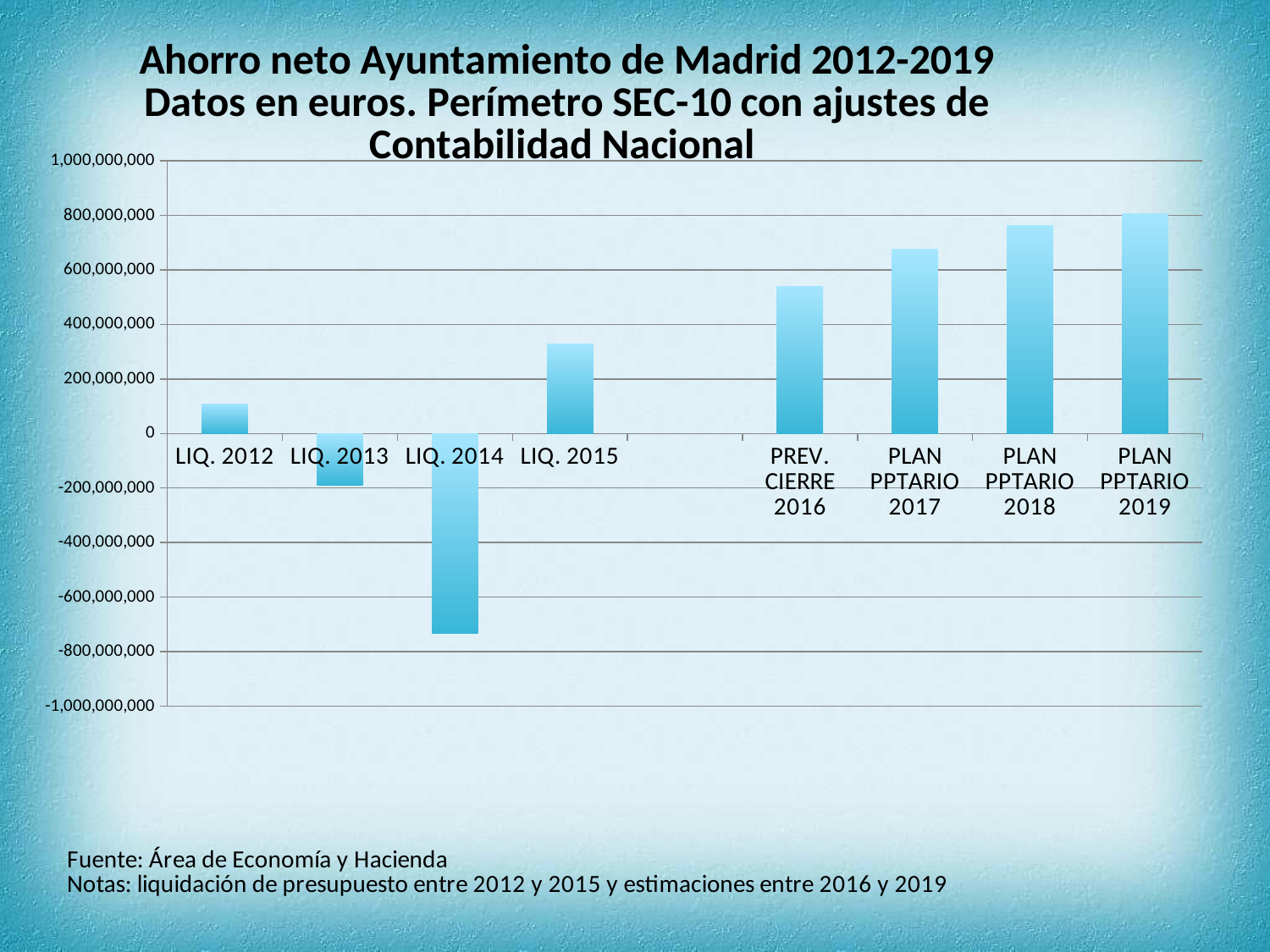
Which category has the highest value? PLAN PPTARIO 2019 Which is larger, the value for LIQ. 2015 or the value for PLAN PPTARIO 2017? PLAN PPTARIO 2017 Is the value for PREV. CIERRE 2016 greater or less than 400,000,000? greater What kind of chart is shown on the slide? bar chart Which category has the lowest value? LIQ. 2014 Is the value for LIQ. 2012 greater or less than 200,000,000? less Which is larger, the value for LIQ. 2013 or the value for LIQ. 2012? LIQ. 2012 Do the values rise or fall from LIQ. 2015 to PLAN PPTARIO 2019? rise What is the first line of the chart title? Ahorro neto Ayuntamiento de Madrid 2012-2019 Is the value for LIQ. 2014 greater or less than -600,000,000? less How many bars are plotted in the chart? 8